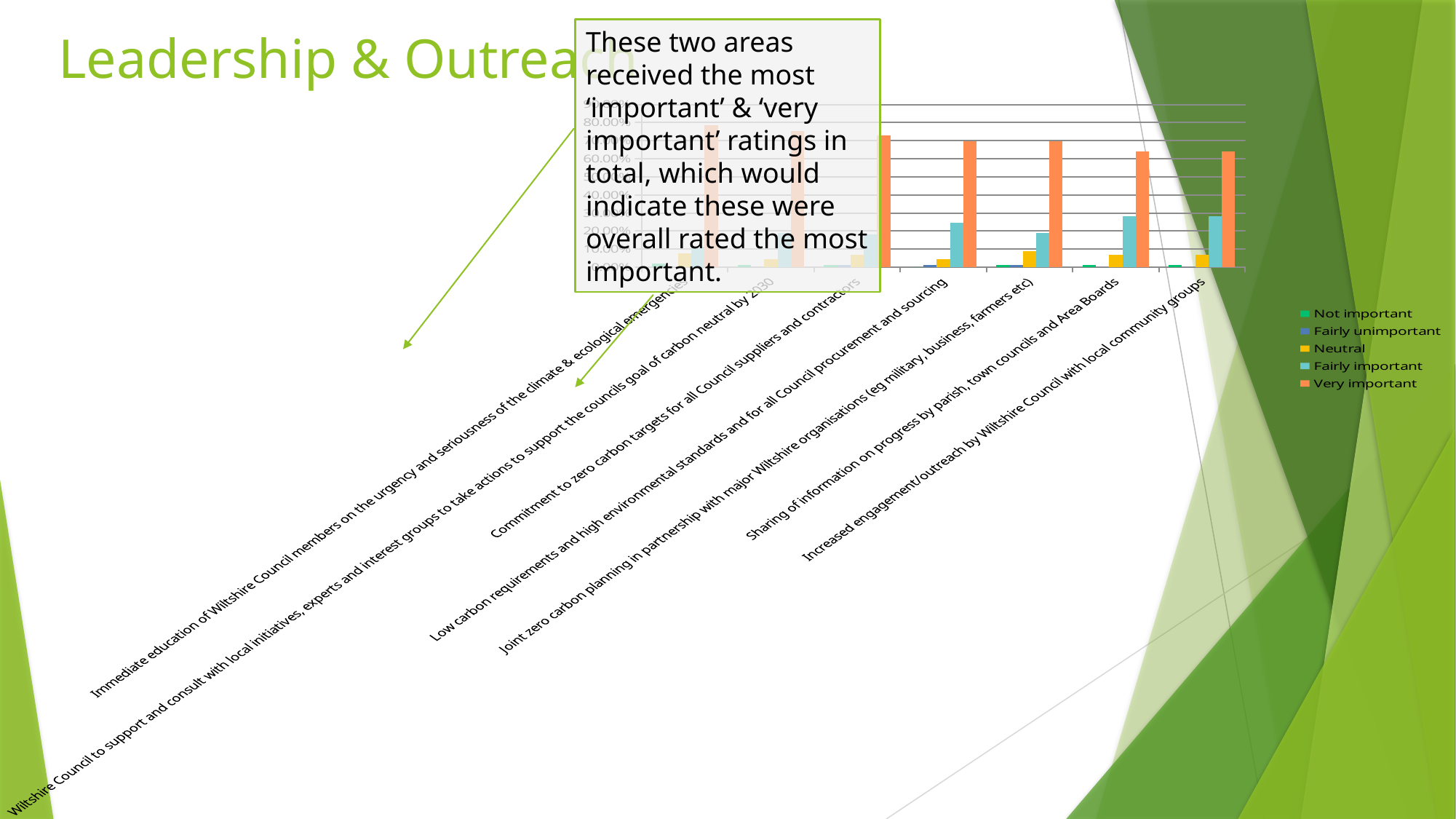
Which series is shown in orange in the chart legend? Very important Which series has the highest value for 'Sharing of information on progress by parish, town councils and Area Boards'? Very important For 'Increased engagement/outreach by Wiltshire Council with local community groups', which is larger: the 'Very important' value or the 'Fairly important' value? Very important Which series is listed first in the chart legend? Not important How many categories are plotted on the chart's x axis? 7 How many series does the chart legend list? 5 Do the 'Very important' values generally rise or fall moving from left to right across the categories? fall Is the 'Fairly important' value for 'Sharing of information on progress by parish, town councils and Area Boards' greater or less than 20.00%? greater Is the 'Neutral' value for 'Joint zero carbon planning in partnership with major Wiltshire organisations (eg military, business, farmers etc)' greater or less than 20.00%? less Is the 'Very important' value for 'Joint zero carbon planning in partnership with major Wiltshire organisations (eg military, business, farmers etc)' greater or less than 60.00%? greater What kind of chart is shown on the slide? bar chart